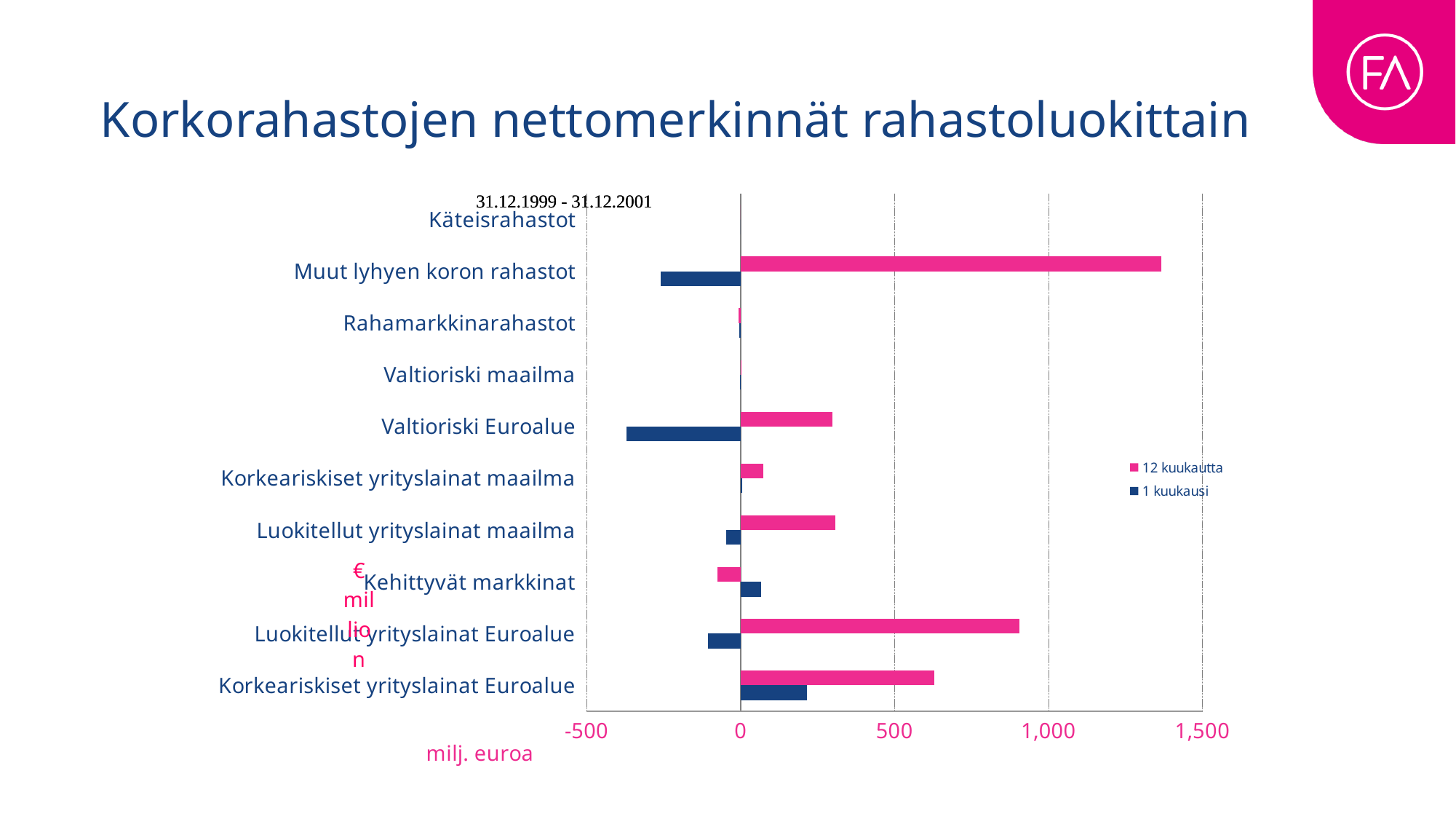
For the 12 kuukautta series, which is larger: Luokitellut yrityslainat Euroalue or Korkeariskiset yrityslainat Euroalue? Luokitellut yrityslainat Euroalue What kind of chart is shown on the slide? Bar chart Is the 12 kuukautta value for Luokitellut yrityslainat Euroalue greater or less than 500? greater Which category has the highest value for the 1 kuukausi series? Korkeariskiset yrityslainat Euroalue Which category has the lowest value for the 1 kuukausi series? Valtioriski Euroalue What unit is shown below the horizontal axis of the chart? milj. euroa Which category has the highest value for the 12 kuukautta series? Muut lyhyen koron rahastot How many series does the legend list? 2 How many fund categories are shown on the vertical axis? 10 Is the 12 kuukautta value for Valtioriski Euroalue greater or less than 500? less For the 1 kuukausi series, which is larger: Korkeariskiset yrityslainat Euroalue or Kehittyvät markkinat? Korkeariskiset yrityslainat Euroalue Is the 12 kuukautta value for Muut lyhyen koron rahastot greater or less than 1,000? greater